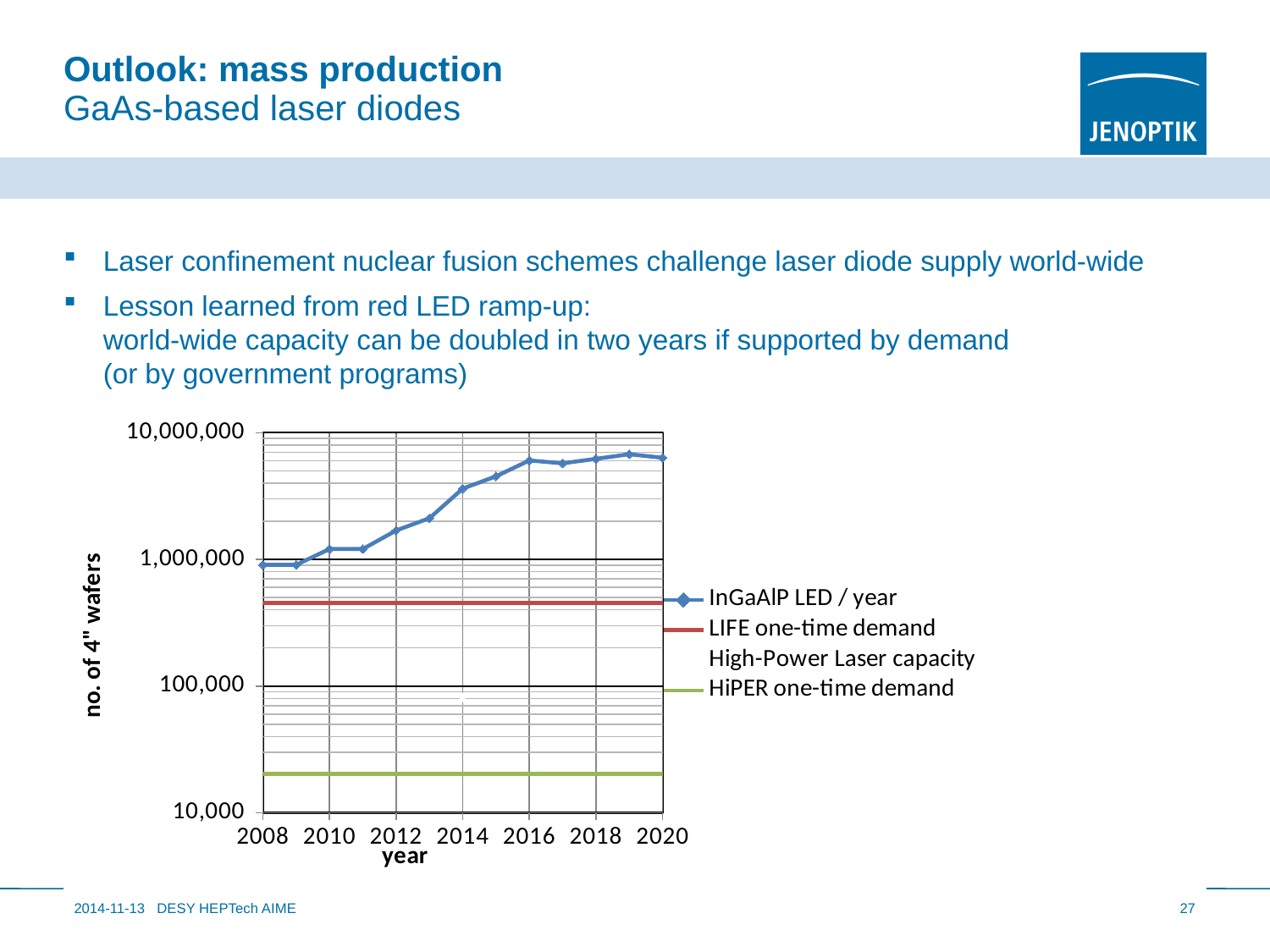
Is the value for LIFE one-time demand greater or less than 1,000,000? less What is the label of the y axis of the chart? no. of 4" wafers How many series does the chart legend list? 4 Is the value for HiPER one-time demand greater or less than 100,000? less Does the InGaAlP LED / year series generally rise or fall from 2008 to 2020? rise Is the value for InGaAlP LED / year in 2012 greater or less than 1,000,000? greater What is the label of the x axis of the chart? year Which is larger, LIFE one-time demand or HiPER one-time demand? LIFE one-time demand Which series has the lowest values on the chart? HiPER one-time demand What kind of chart is shown on the slide? line chart